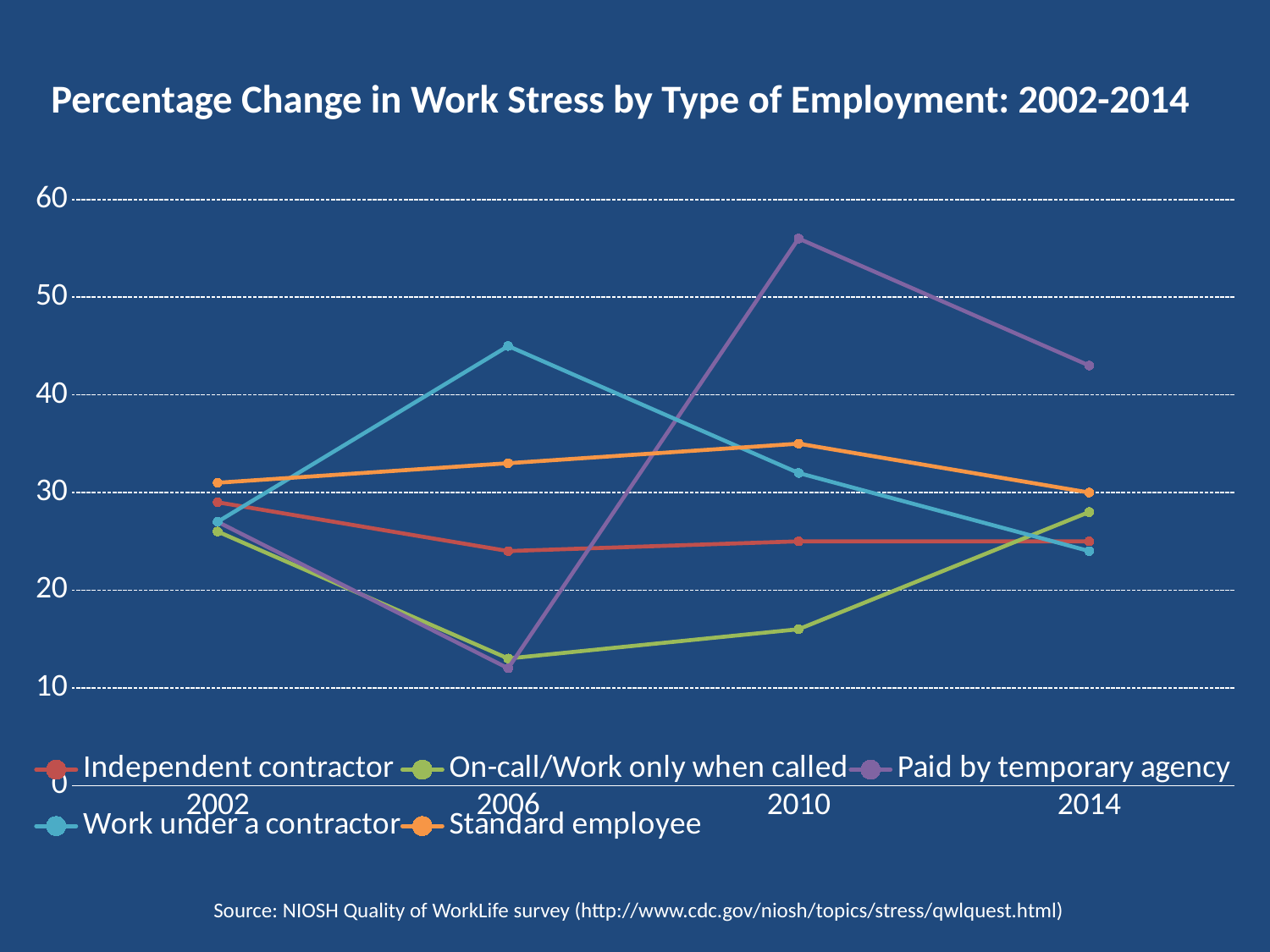
What is the title of the chart? Percentage Change in Work Stress by Type of Employment: 2002-2014 Which type of employment has the highest value in 2006? Work under a contractor Does the value for On-call/Work only when called rise or fall from 2006 to 2014? rise Which type of employment has the lowest value in 2010? On-call/Work only when called How many years are plotted along the x axis? 4 Is the value for Paid by temporary agency in 2010 greater or less than 50? greater Is the value for Work under a contractor in 2006 greater or less than 40? greater Which type of employment has the highest value in 2010? Paid by temporary agency What kind of chart is shown on the slide? line chart Is the value for On-call/Work only when called in 2010 greater or less than 20? less How many series does the legend list? 5 In 2006, which is larger: the value for Standard employee or the value for Independent contractor? Standard employee